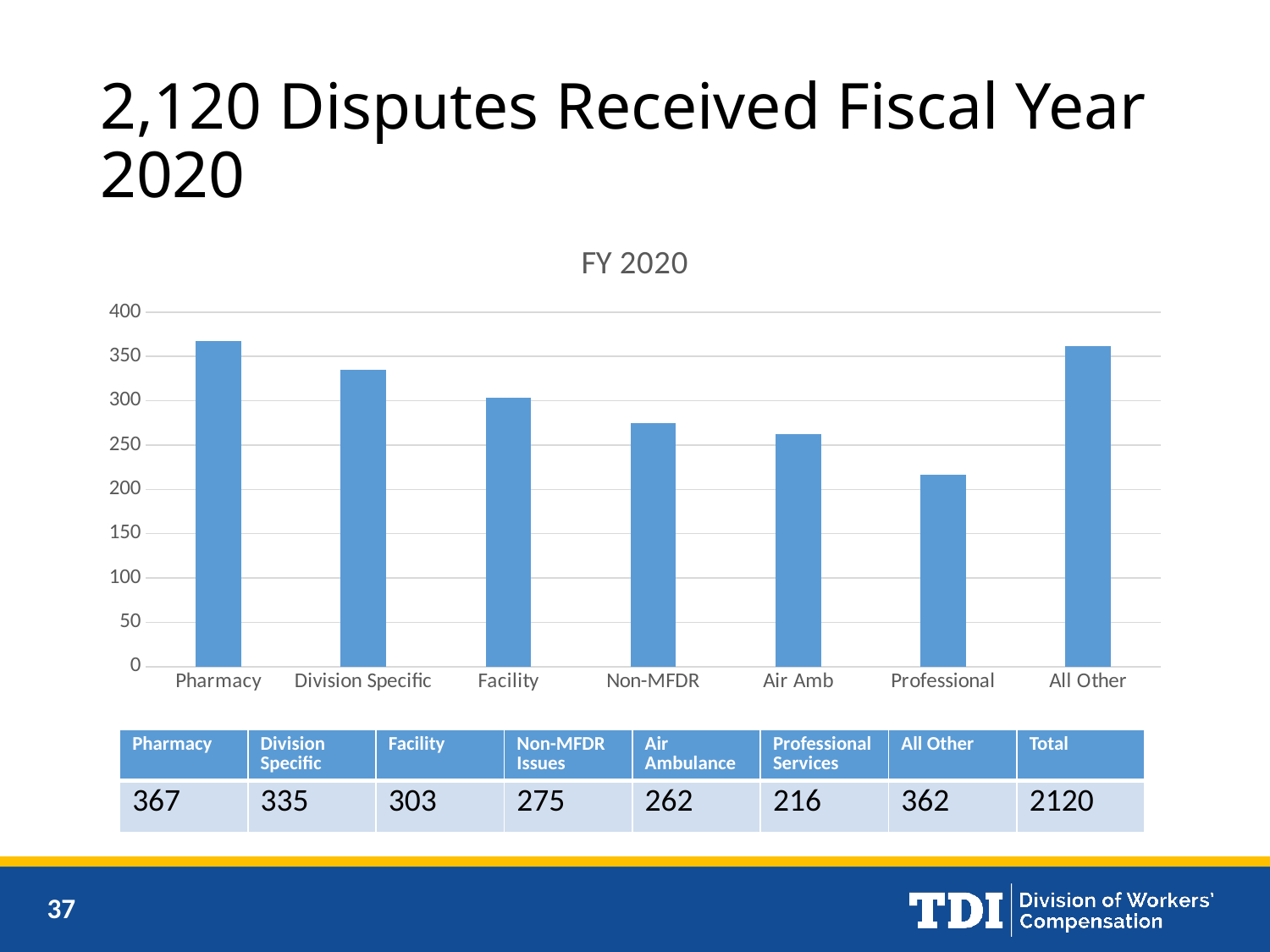
Which is larger, the value for Facility or the value for Air Amb? Facility Is the value for Air Amb greater or less than 250? greater What is the difference between the values for Division Specific and Facility? 32 What is the value for Non-MFDR in the FY 2020 chart? 275 What is the value for Professional in the FY 2020 chart? 216 What kind of chart is shown on the slide? bar chart What is the difference between the values for Pharmacy and Professional? 151 Which category has the highest value in the FY 2020 chart? Pharmacy What is the title of the chart on the slide? FY 2020 Which category has the lowest value in the FY 2020 chart? Professional How many categories are shown in the FY 2020 chart? 7 What is the value for Pharmacy in the FY 2020 chart? 367